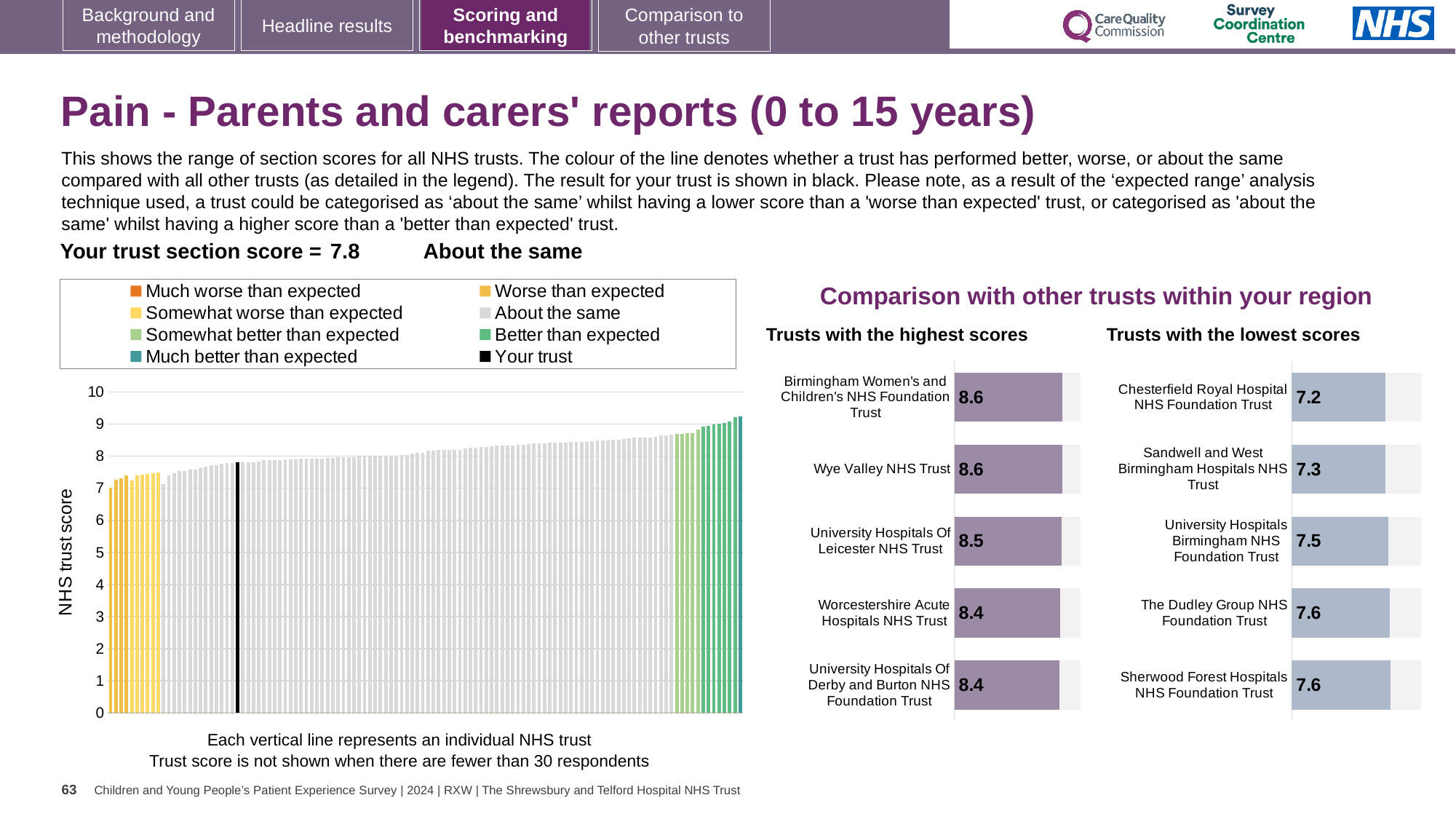
On the main chart showing the range of section scores for all NHS trusts, what is the section score for your trust (the black bar)? 7.8 How many entries does the legend of the main chart showing the range of section scores list? 8 On the 'Trusts with the lowest scores' chart, what is the score for The Dudley Group NHS Foundation Trust? 7.6 What kind of chart is the main chart showing the range of section scores for all NHS trusts? bar chart On the 'Trusts with the highest scores' chart, which has the higher score: University Hospitals Of Leicester NHS Trust or Worcestershire Acute Hospitals NHS Trust? University Hospitals Of Leicester NHS Trust On the main chart showing the range of section scores for all NHS trusts, do the bar values rise or fall from left to right? rise On the 'Trusts with the highest scores' chart, what is the difference between the scores of Birmingham Women's and Children's NHS Foundation Trust and Worcestershire Acute Hospitals NHS Trust? 0.2 On the 'Trusts with the highest scores' chart, what is the score for University Hospitals Of Leicester NHS Trust? 8.5 How many trusts are listed on the 'Trusts with the lowest scores' chart? 5 On the 'Trusts with the lowest scores' chart, what is the difference between the scores of Sherwood Forest Hospitals NHS Foundation Trust and Chesterfield Royal Hospital NHS Foundation Trust? 0.4 On the 'Trusts with the lowest scores' chart, which trust has the lowest score? Chesterfield Royal Hospital NHS Foundation Trust On the 'Trusts with the highest scores' chart, what is the score for Wye Valley NHS Trust? 8.6